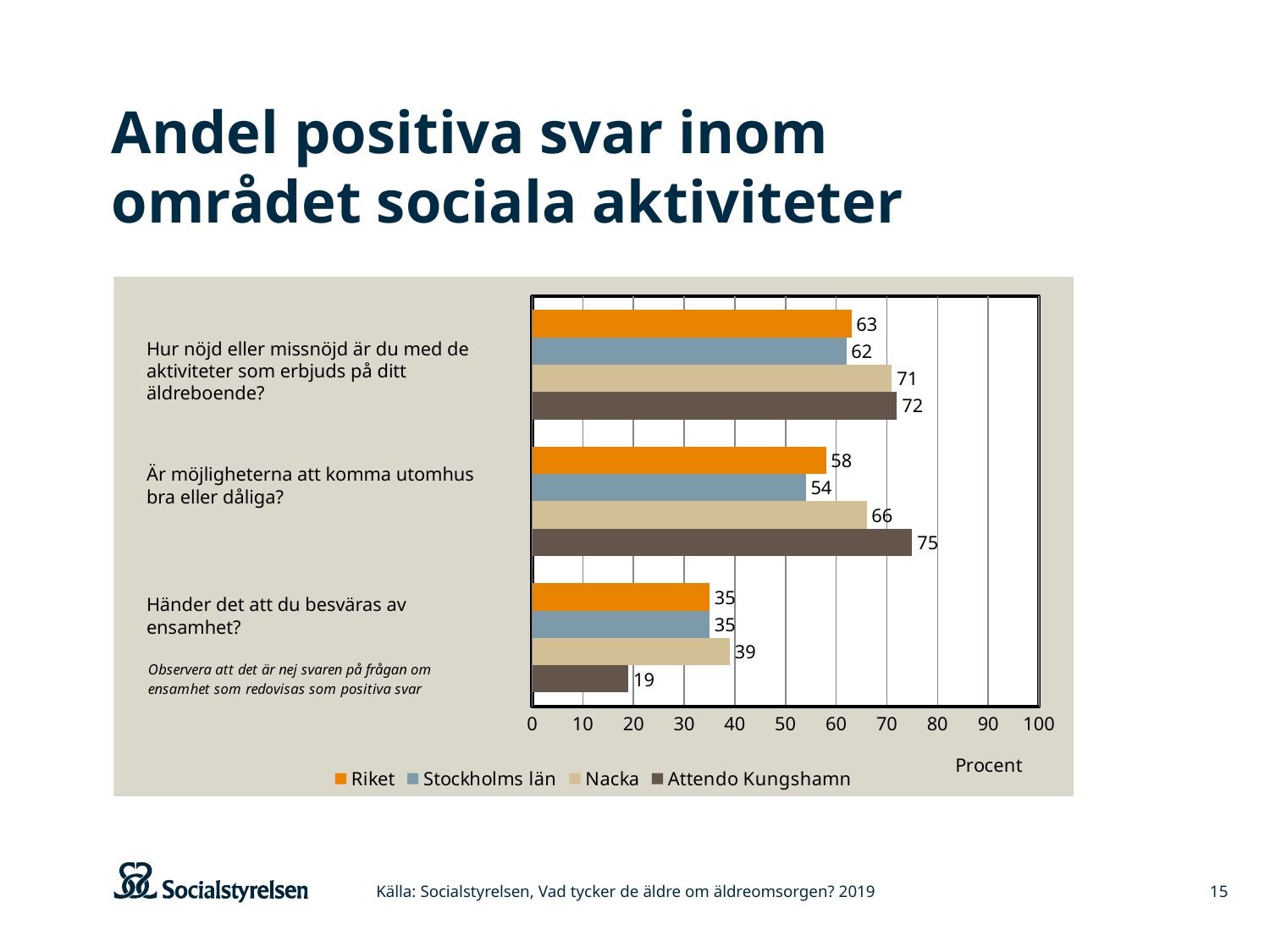
What kind of chart is shown on the slide? Bar chart What is the difference between Attendo Kungshamn and Riket on the question "Är möjligheterna att komma utomhus bra eller dåliga?"? 17 Which series has the highest value on the question "Är möjligheterna att komma utomhus bra eller dåliga?"? Attendo Kungshamn Which is larger on the question "Hur nöjd eller missnöjd är du med de aktiviteter som erbjuds på ditt äldreboende?": Riket or Nacka? Nacka What is the value for Nacka on the question "Hur nöjd eller missnöjd är du med de aktiviteter som erbjuds på ditt äldreboende?"? 71 What is the difference between Nacka and Stockholms län on the question "Händer det att du besväras av ensamhet?"? 4 What is the value for Riket on the question "Händer det att du besväras av ensamhet?"? 35 Which series has the lowest value on the question "Händer det att du besväras av ensamhet?"? Attendo Kungshamn How many questions (categories) are shown on the chart? 3 What is the label on the horizontal axis of the chart? Procent How many series does the legend list? 4 What is the value for Attendo Kungshamn on the question "Är möjligheterna att komma utomhus bra eller dåliga?"? 75